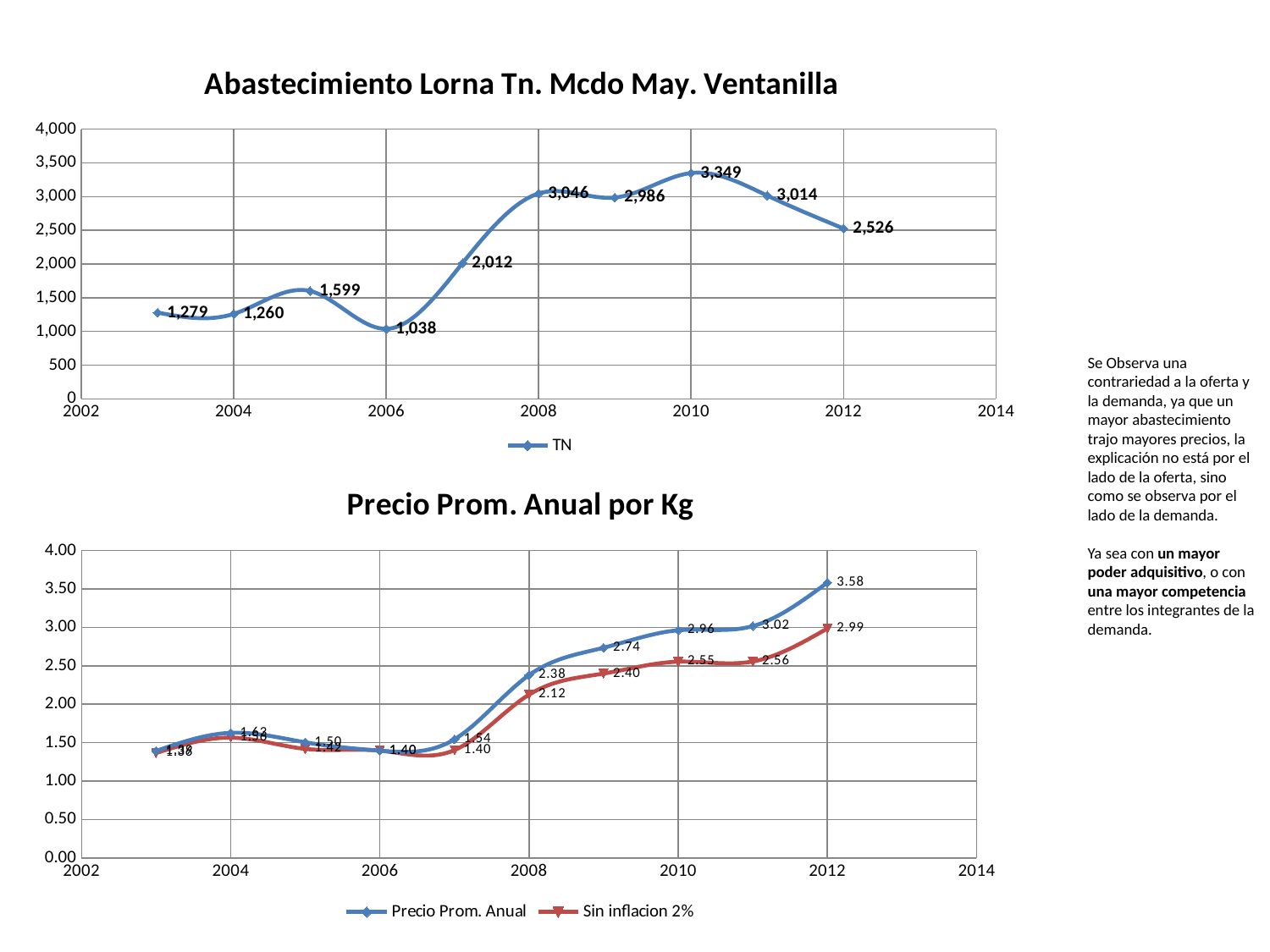
In the chart titled 'Precio Prom. Anual por Kg', which is larger in 2011: 'Precio Prom. Anual' or 'Sin inflacion 2%'? Precio Prom. Anual In the chart titled 'Abastecimiento Lorna Tn. Mcdo May. Ventanilla', what is the TN value for 2010? 3,349 In the chart titled 'Abastecimiento Lorna Tn. Mcdo May. Ventanilla', which year has the highest TN value? 2010 In the chart titled 'Precio Prom. Anual por Kg', what is the 'Precio Prom. Anual' value for 2012? 3.58 In the chart titled 'Abastecimiento Lorna Tn. Mcdo May. Ventanilla', what is the difference between the TN values for 2008 and 2007? 1,034 In the chart titled 'Abastecimiento Lorna Tn. Mcdo May. Ventanilla', which year has the lowest TN value? 2006 In the chart titled 'Precio Prom. Anual por Kg', what is the difference between 'Precio Prom. Anual' and 'Sin inflacion 2%' in 2012? 0.59 In the chart titled 'Abastecimiento Lorna Tn. Mcdo May. Ventanilla', how many data points are plotted? 10 What type of chart is the top chart, 'Abastecimiento Lorna Tn. Mcdo May. Ventanilla'? Line chart In the chart titled 'Precio Prom. Anual por Kg', how many series does the legend list? 2 In the chart titled 'Precio Prom. Anual por Kg', do the 'Precio Prom. Anual' values generally rise or fall from 2007 to 2012? Rise In the chart titled 'Precio Prom. Anual por Kg', what is the 'Sin inflacion 2%' value for 2009? 2.40